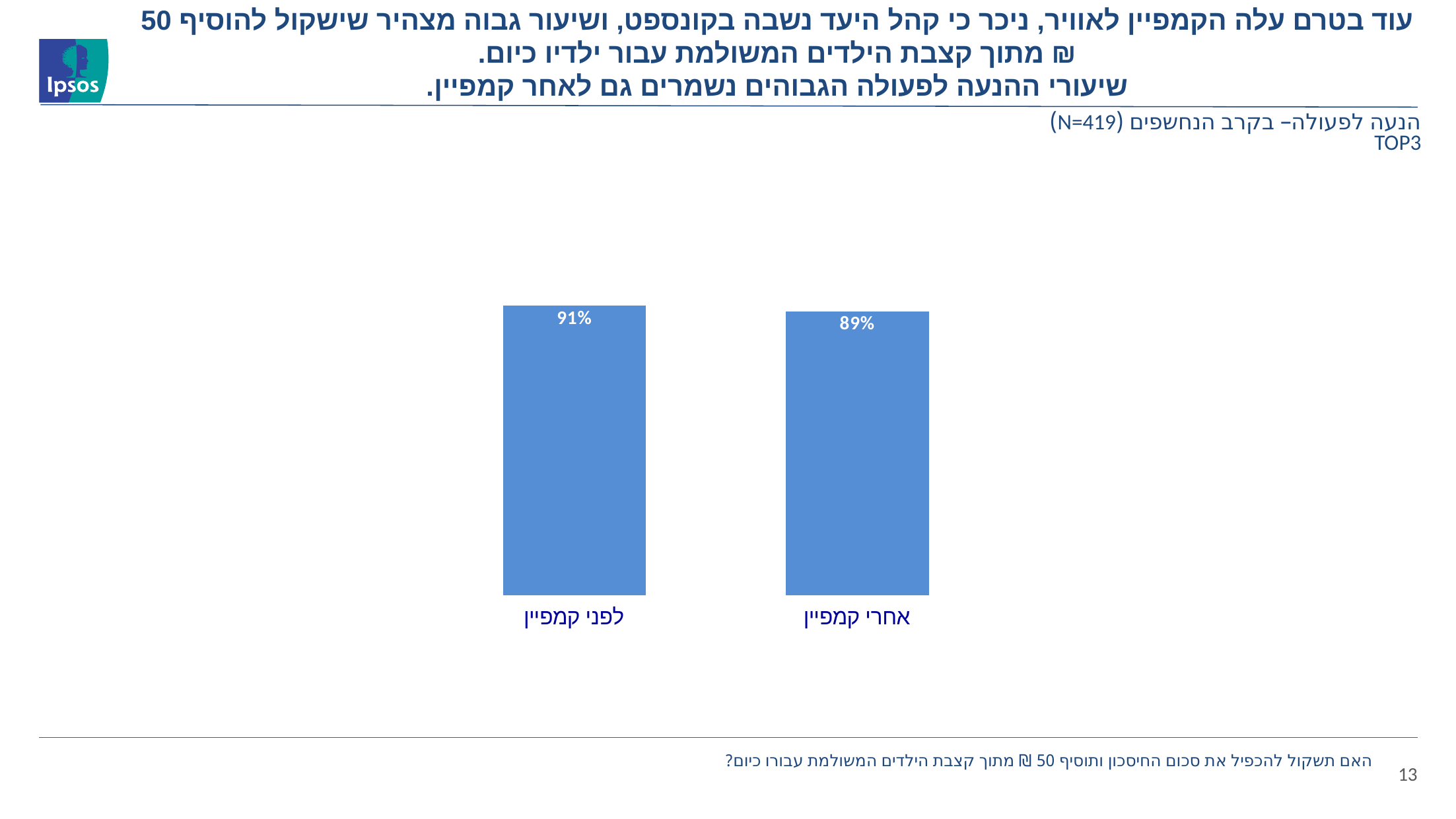
Which category has the highest value? לפני קמפיין Do the values rise or fall from לפני קמפיין to אחרי קמפיין? fall What is the sample size (N) stated in the chart subtitle? N=419 Which category has the lowest value? אחרי קמפיין What kind of chart is shown on the slide? bar chart What is the value for אחרי קמפיין? 89% Which is larger, the value for לפני קמפיין or the value for אחרי קמפיין? לפני קמפיין How many categories are shown in the chart? 2 What colour are the bars in the chart? blue What is the difference between the values for לפני קמפיין and אחרי קמפיין? 2% What is the value for לפני קמפיין? 91%